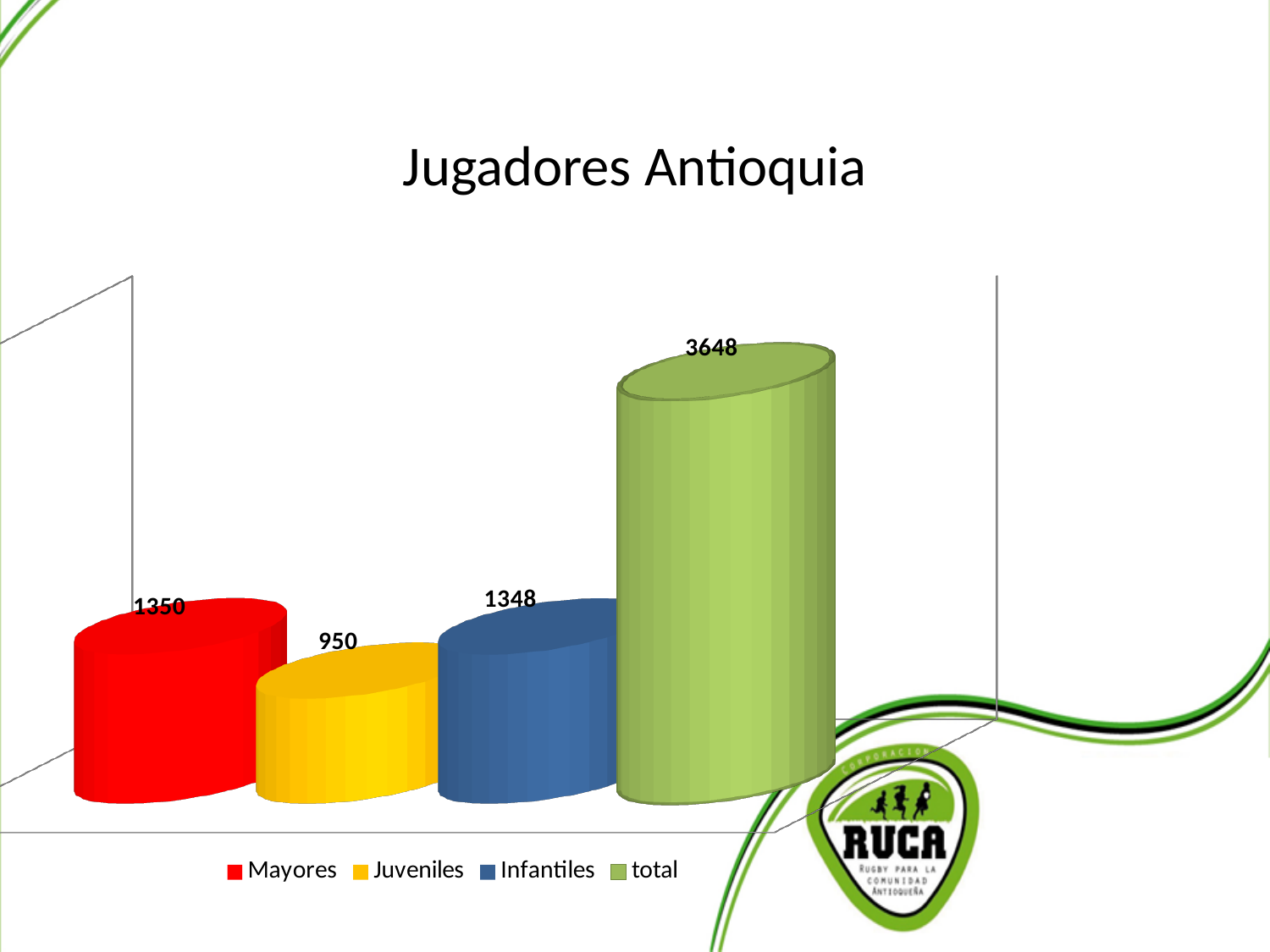
How many series does the legend list? 4 What is the value for Mayores? 1350 Which series has the highest value? total What is the value for total? 3648 What is the title of the chart? Jugadores Antioquia What is the difference between the values for Mayores and Juveniles? 400 What is the value for Juveniles? 950 What is the difference between the values for Infantiles and Juveniles? 398 What is the value for Infantiles? 1348 What kind of chart is shown on the slide? Bar chart Which series has the lowest value? Juveniles Which is larger, the value for Juveniles or the value for Infantiles? Infantiles